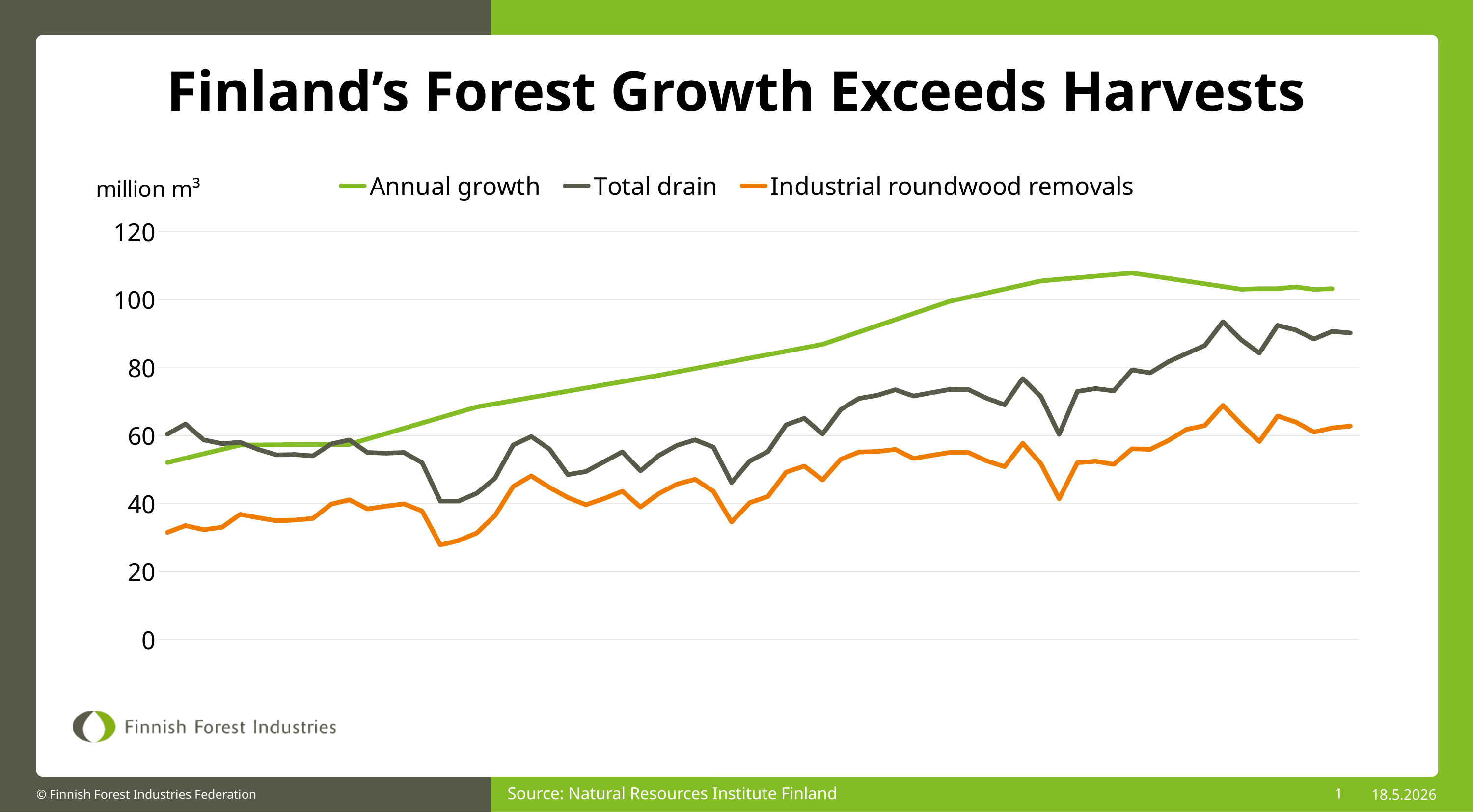
Does the Annual growth line generally rise or fall from left to right? rise Is the highest point of the Total drain line greater or less than 80? greater Is the final (rightmost) value of Annual growth greater or less than 100? greater Which series reaches the highest value on the chart? Annual growth What is the title of the chart on the slide? Finland's Forest Growth Exceeds Harvests Is the lowest point of the Industrial roundwood removals line greater or less than 40? less At the right end of the chart, which is higher: Annual growth or Total drain? Annual growth How many series does the legend list? 3 What unit is shown on the vertical axis of the chart? million m³ What kind of chart is shown on the slide? line chart At the right end of the chart, which is higher: Total drain or Industrial roundwood removals? Total drain